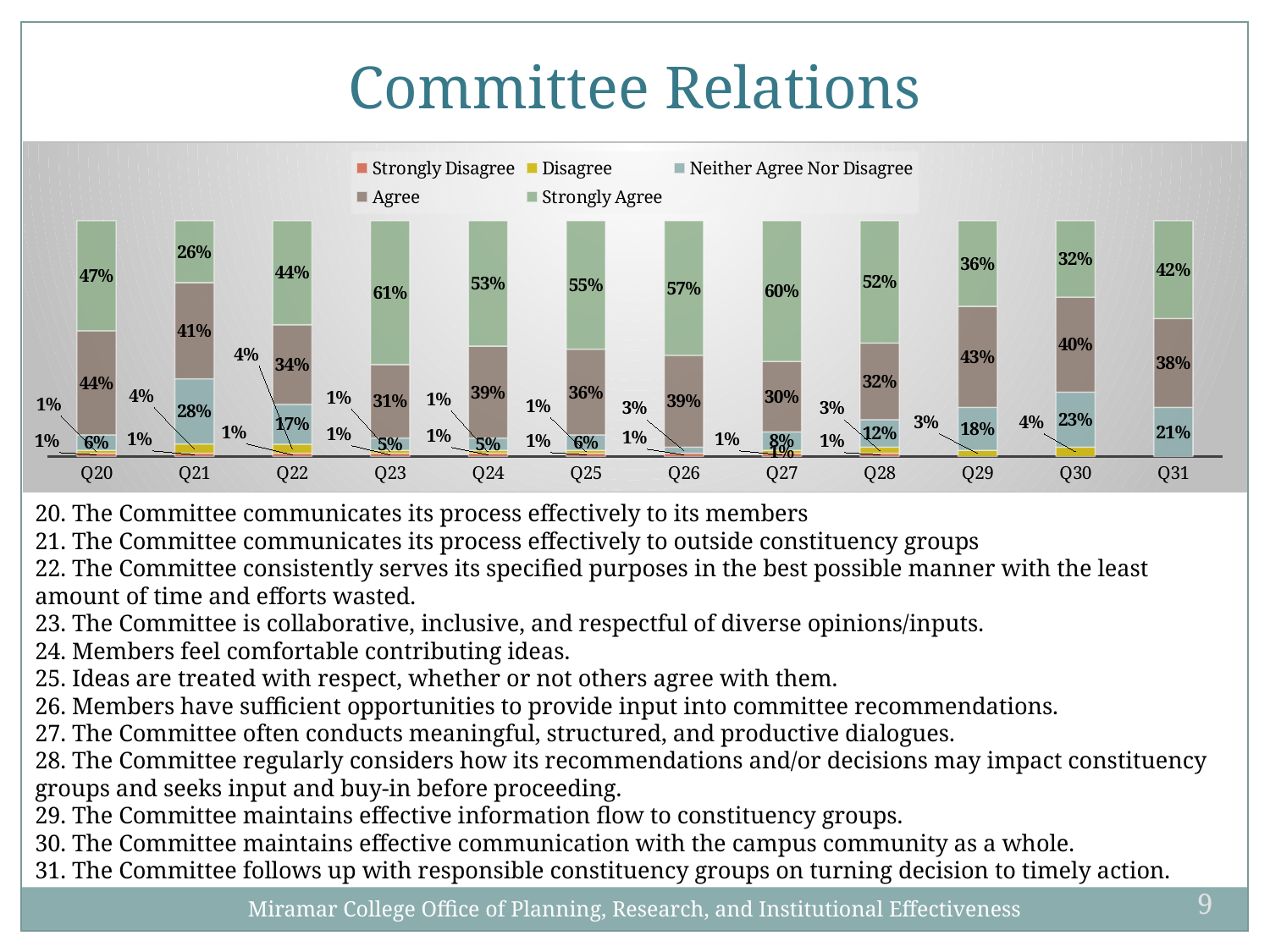
What is the Agree value for Q20? 44% Which question has the highest Strongly Agree value? Q23 What kind of chart is shown on the slide? stacked bar chart Which question has the lowest Strongly Agree value? Q21 Which is larger, the Agree value for Q29 or the Agree value for Q30? Q29 What is the Strongly Agree value for Q31? 42% What is the title of the chart? Committee Relations What is the Strongly Agree value for Q23? 61% How many question categories are plotted along the x axis? 12 How many series does the legend list? 5 What is the Neither Agree Nor Disagree value for Q21? 28% What is the difference between the Strongly Agree values for Q23 and Q21? 35%